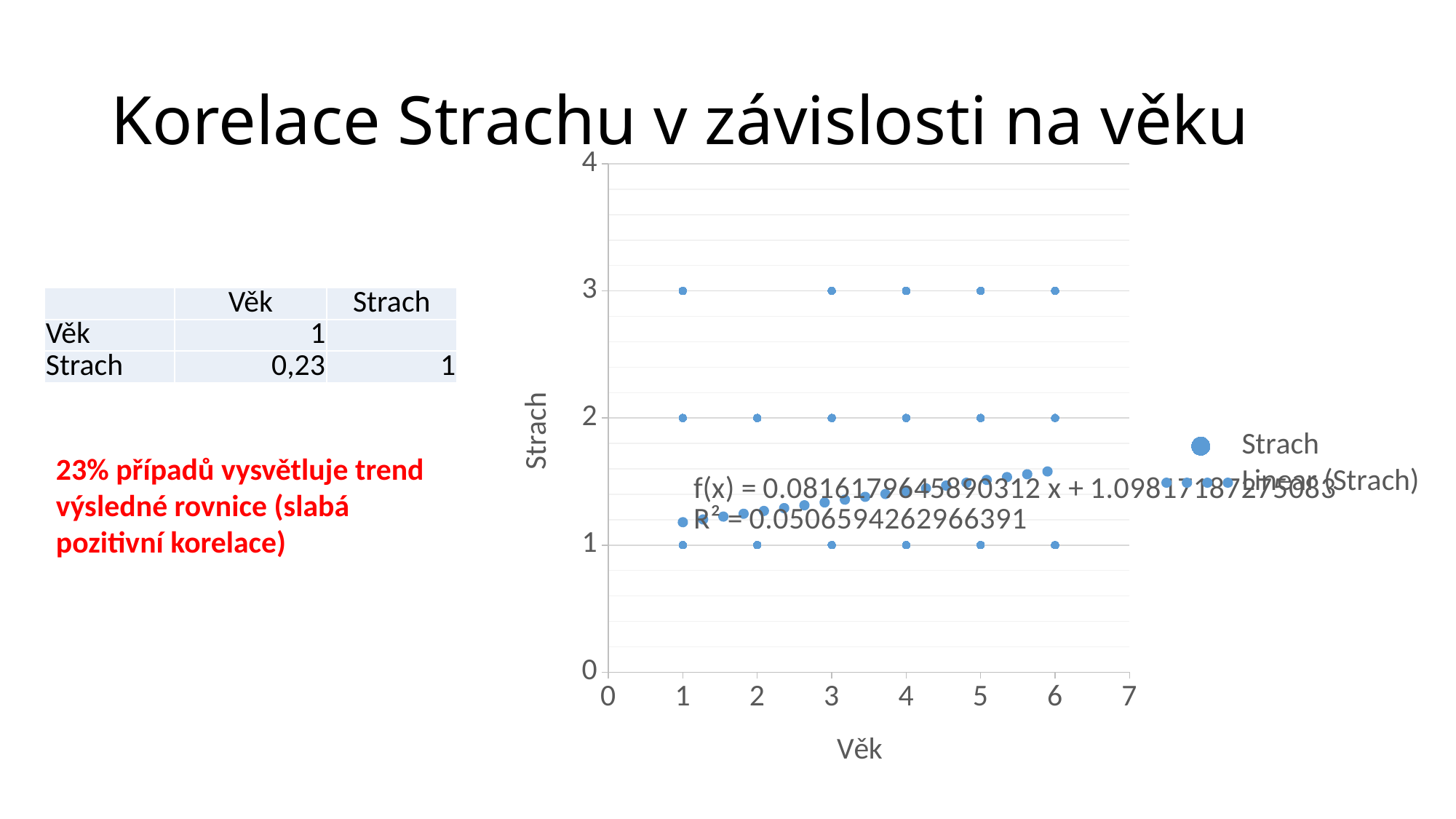
What kind of chart is shown on the slide? scatter chart Is the trendline value at Věk = 1 greater or less than 1? greater How many series does the chart legend list? 2 What is the title of the chart's y axis? Strach What is the highest Strach value plotted in the chart? 3 What is the lowest Strach value plotted in the chart? 1 What is the title of the chart's x axis? Věk Is the trendline value at Věk = 6 greater or less than 2? less How many distinct Věk values have data points plotted in the chart? 6 Does the linear trendline rise or fall as Věk increases? rises What is the slope of the trendline equation printed on the chart? 0.0816179645890312 What R² value is printed on the chart? 0.0506594262966391